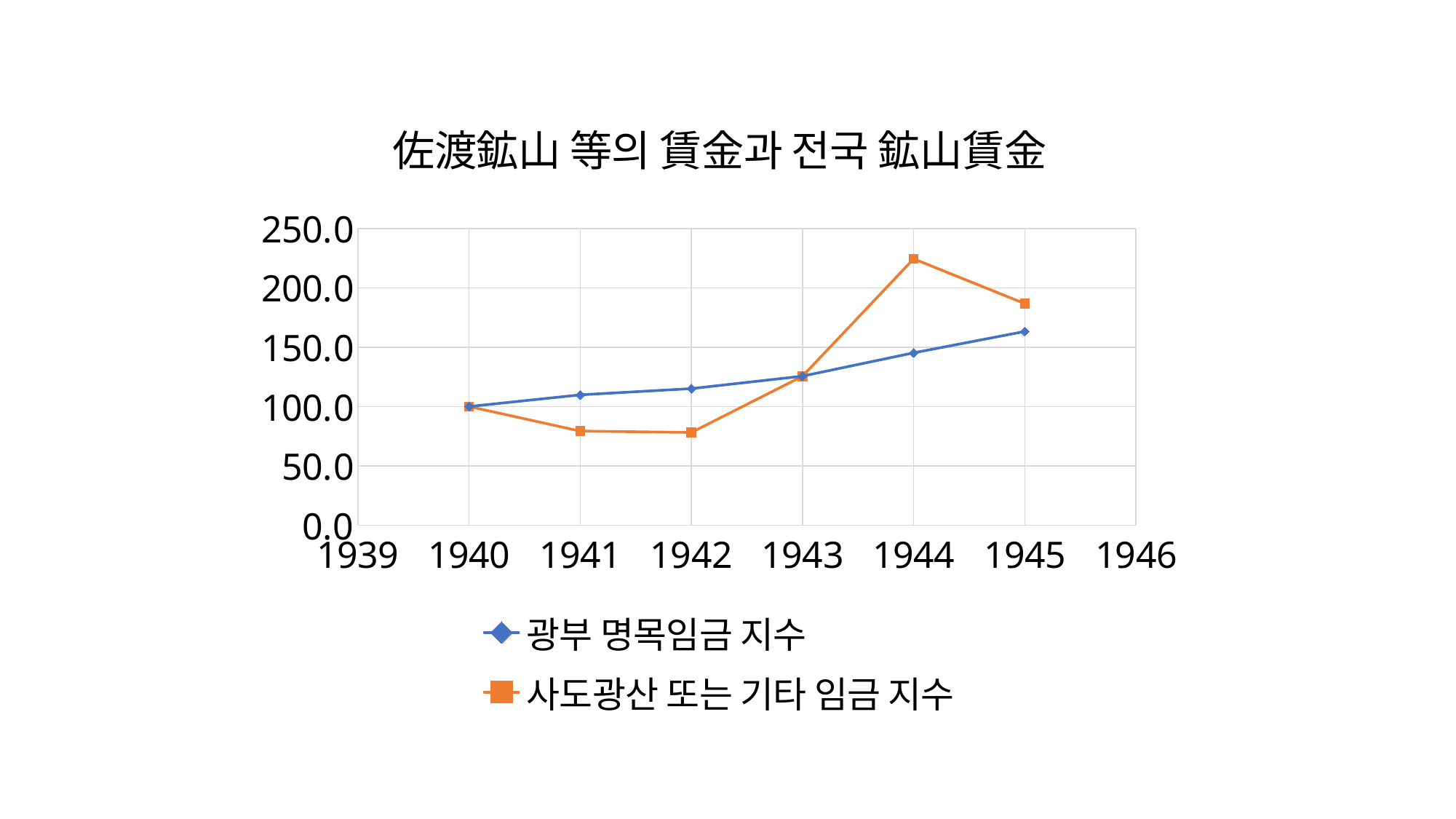
How many data points does the 광부 명목임금 지수 series have? 6 Does 광부 명목임금 지수 rise or fall from 1940 to 1945? rise How many series does the legend list? 2 What is the value of 사도광산 또는 기타 임금 지수 in 1940? 100.0 Is the value for 광부 명목임금 지수 in 1945 greater or less than 150.0? greater In 1944, which series has the larger value, 광부 명목임금 지수 or 사도광산 또는 기타 임금 지수? 사도광산 또는 기타 임금 지수 What kind of chart is shown on the slide? line chart What is the value of 광부 명목임금 지수 in 1940? 100.0 In which year is 사도광산 또는 기타 임금 지수 highest? 1944 Is the value for 사도광산 또는 기타 임금 지수 in 1941 greater or less than 100.0? less In which year is 광부 명목임금 지수 lowest? 1940 Is the value for 사도광산 또는 기타 임금 지수 in 1944 greater or less than 200.0? greater